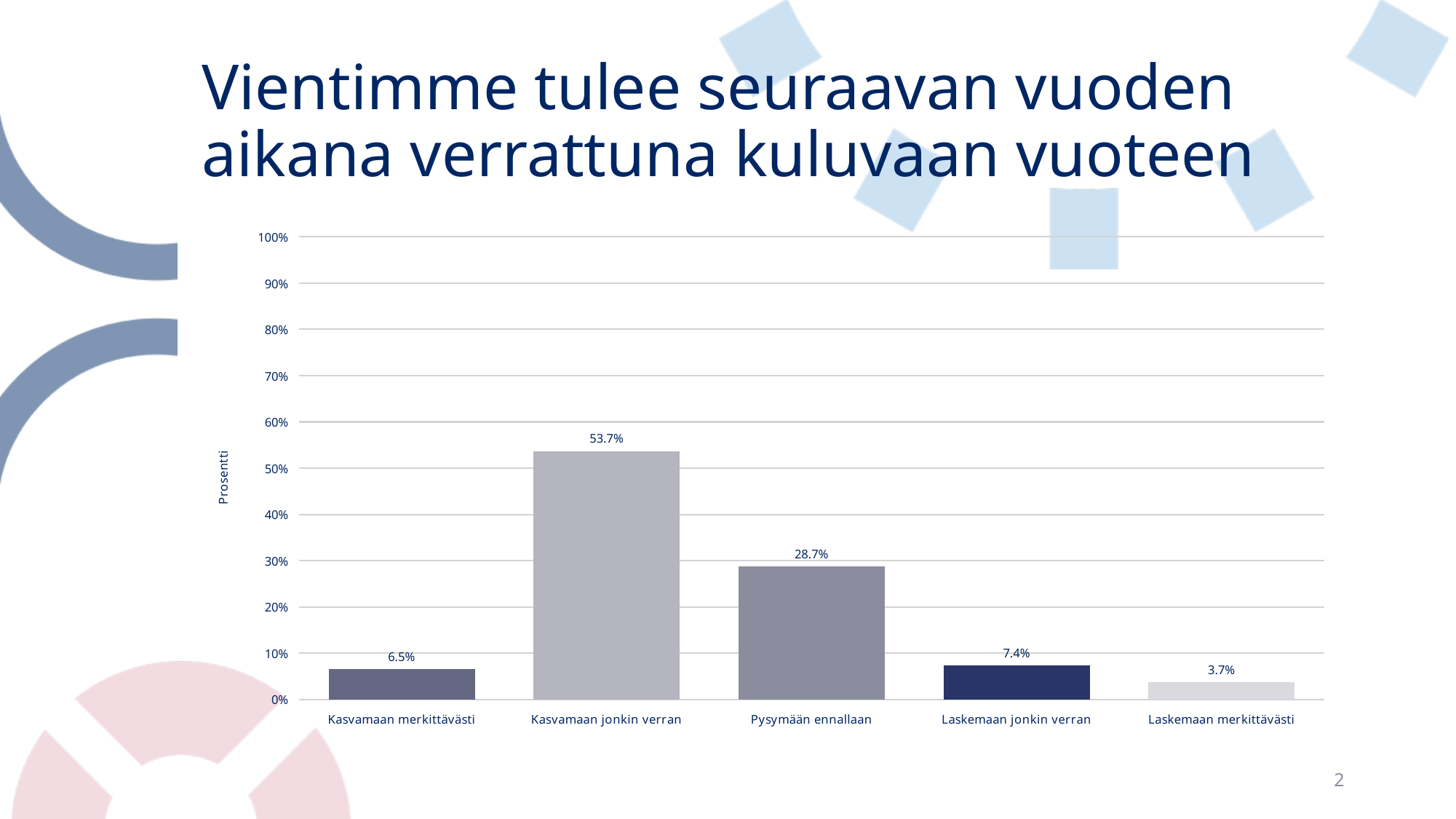
What is the value for Kasvamaan jonkin verran? 53.7% Is the value for Pysymään ennallaan greater or less than 30%? less What is the value for Laskemaan merkittävästi? 3.7% What is the label of the vertical axis? Prosentti What is the difference between the values for Kasvamaan jonkin verran and Pysymään ennallaan? 25 percentage points What kind of chart is shown on the slide? Bar chart What is the value for Kasvamaan merkittävästi? 6.5% Which is larger, the value for Laskemaan jonkin verran or the value for Kasvamaan merkittävästi? Laskemaan jonkin verran What is the value for Pysymään ennallaan? 28.7% Which category has the lowest value? Laskemaan merkittävästi How many categories are shown on the x axis? 5 Which category has the highest value? Kasvamaan jonkin verran